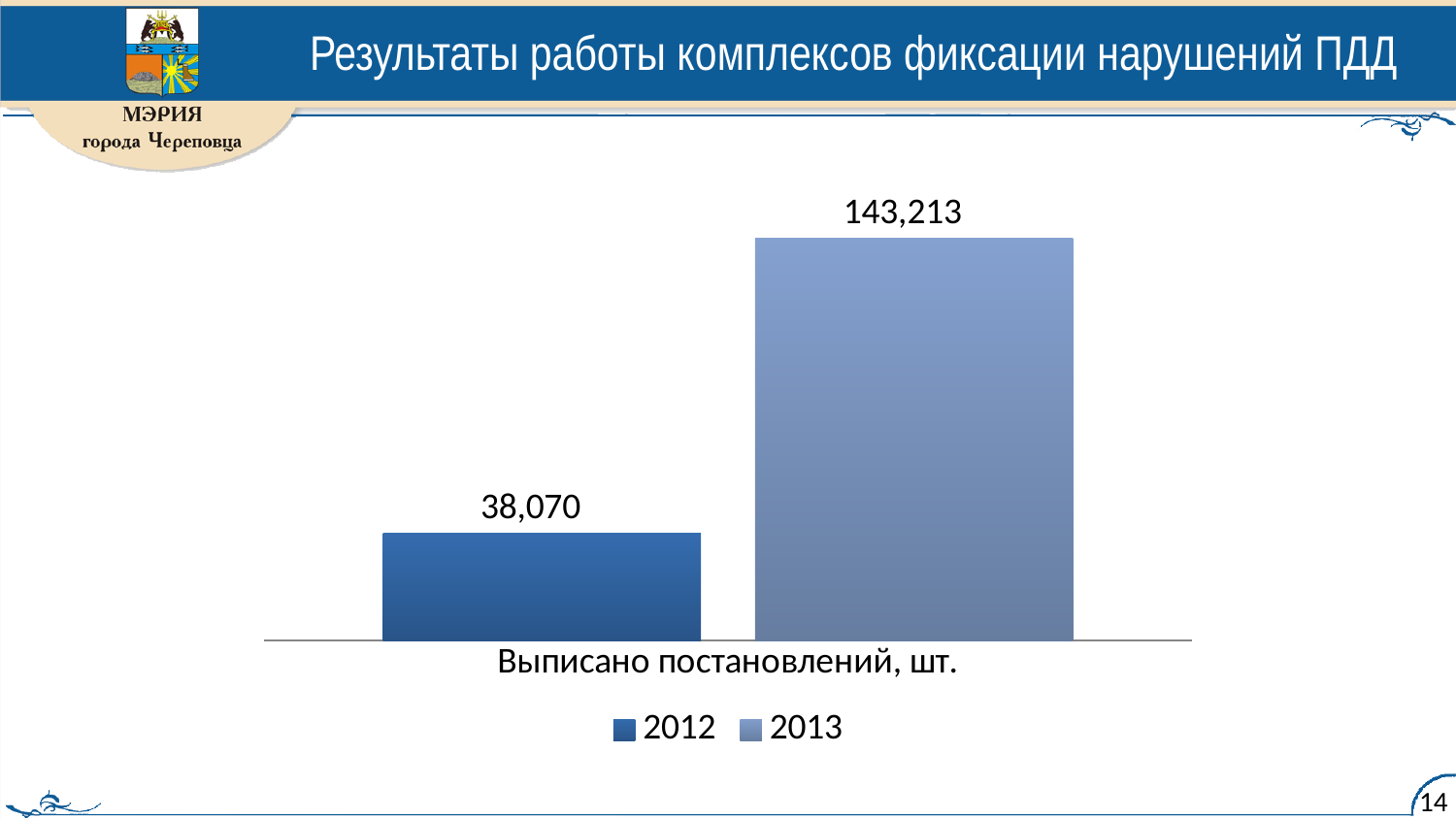
Did the number of issued resolutions rise or fall from 2012 to 2013? Rise How many bars are plotted in the chart? 2 What is the difference between the 2013 and 2012 values? 105,143 How many series does the legend list? 2 What is the category label shown under the bars? Выписано постановлений, шт. Which year has the higher value, 2012 or 2013? 2013 What kind of chart is shown on the slide? Bar chart What is the title of the slide containing the chart? Результаты работы комплексов фиксации нарушений ПДД Which series has the lowest value in the chart? 2012 What is the value for 2013 in the chart? 143,213 What is the value for 2012 in the chart? 38,070